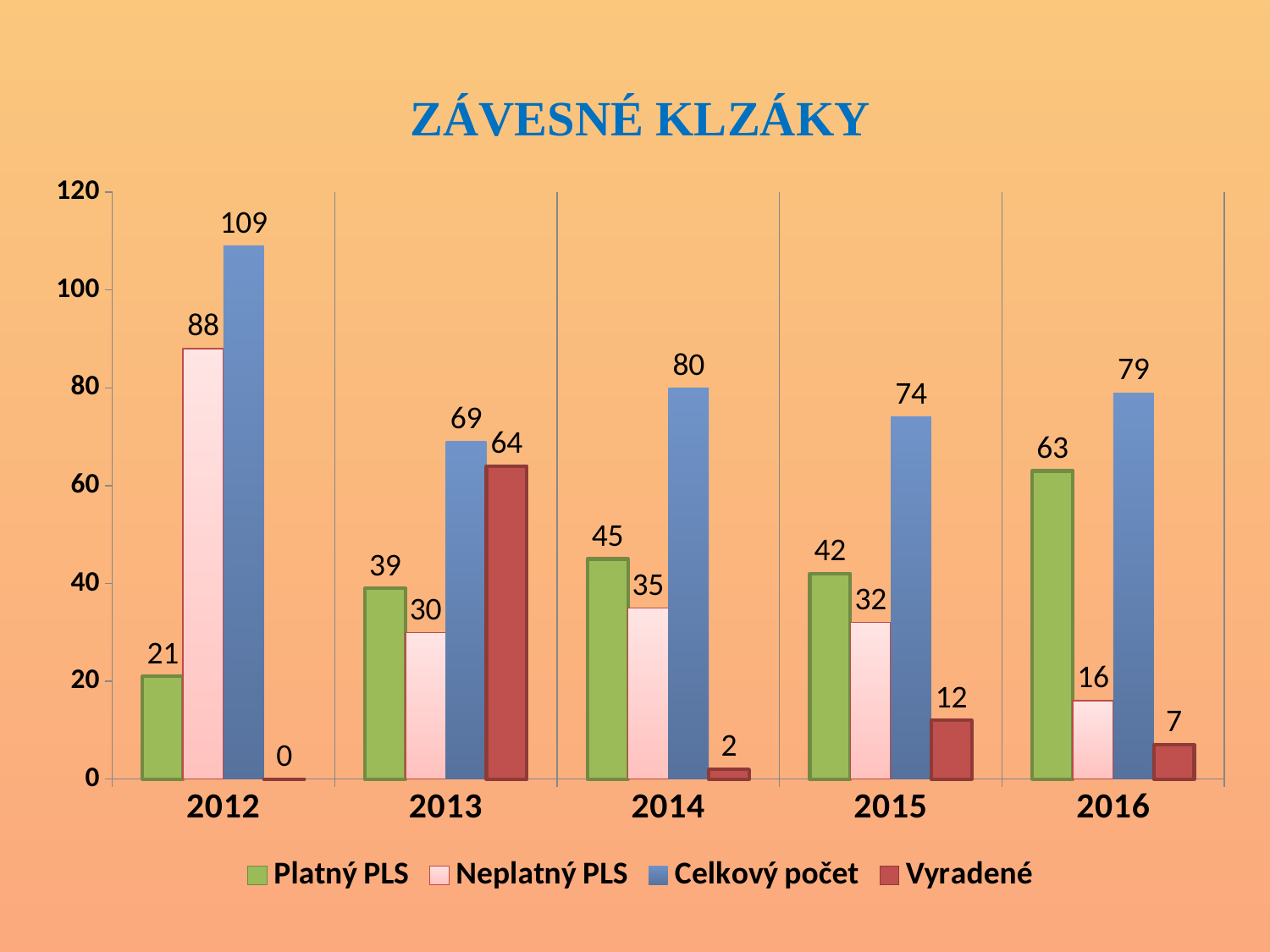
What is the value of Platný PLS for 2016? 63 In which year is Platný PLS lowest? 2012 What is the title of the chart? ZÁVESNÉ KLZÁKY What is the value of Neplatný PLS for 2015? 32 How many years are shown on the x axis? 5 What is the difference between Celkový počet and Platný PLS in 2014? 35 What kind of chart is shown? Bar chart What is the value of Celkový počet for 2012? 109 How many series does the legend list? 4 Which is larger in 2013: Platný PLS or Neplatný PLS? Platný PLS What is the value of Vyradené for 2013? 64 In which year is Celkový počet highest? 2012